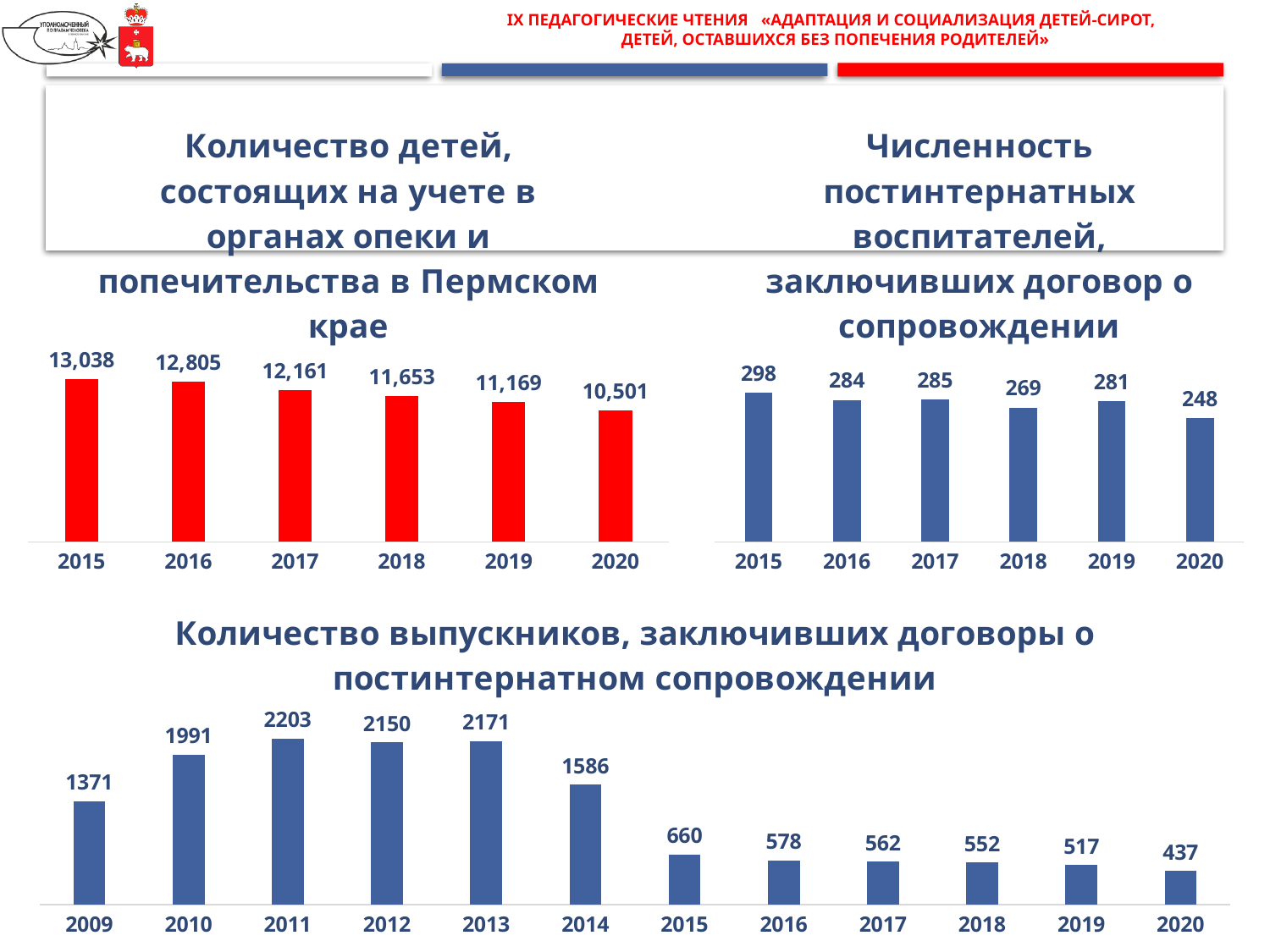
In the top-right chart (Численность постинтернатных воспитателей), how many years are shown? 6 In the top-left chart (Количество детей, состоящих на учете), do the values rise or fall from 2015 to 2020? fall In the top-left chart (Количество детей, состоящих на учете в органах опеки и попечительства в Пермском крае), what is the value for 2017? 12,161 In the bottom chart (Количество выпускников, заключивших договоры о постинтернатном сопровождении), what is the value for 2014? 1586 In the bottom chart (Количество выпускников), how many years are shown? 12 In the top-right chart (Численность постинтернатных воспитателей), which is larger, the value for 2016 or the value for 2019? 2016 In the top-left chart (Количество детей, состоящих на учете), what is the difference between the 2015 and 2020 values? 2,537 What kind of chart is the bottom chart (Количество выпускников)? bar chart In the top-right chart (Численность постинтернатных воспитателей), what is the value for 2018? 269 In the top-right chart (Численность постинтернатных воспитателей), which year has the highest value? 2015 In the bottom chart (Количество выпускников), which year has the highest value? 2011 In the top-left chart (Количество детей, состоящих на учете), which year has the lowest value? 2020